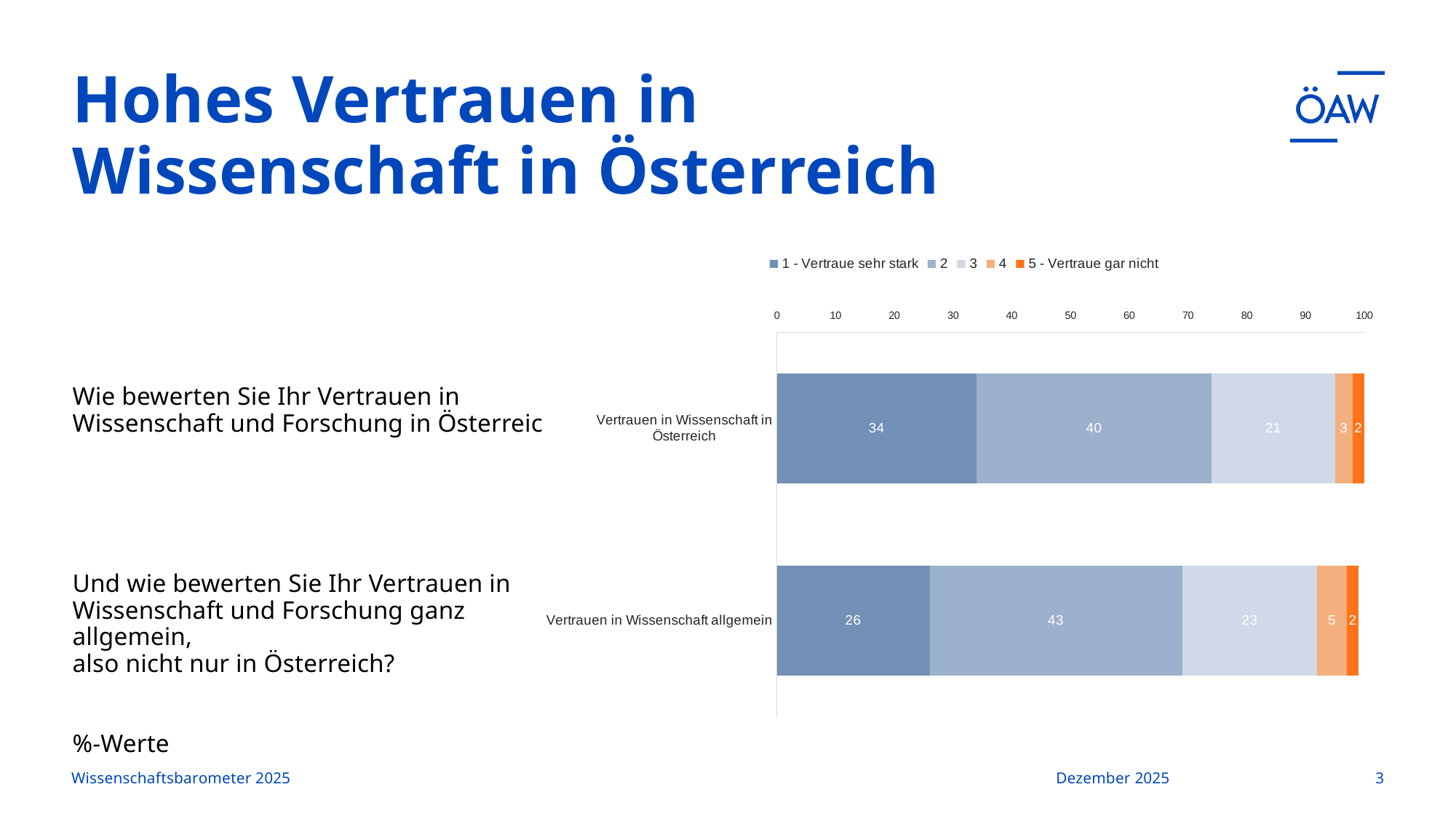
What is the value of series "2" for "Vertrauen in Wissenschaft allgemein"? 43 How many categories (bars) are plotted in the chart? 2 What is the total of the stacked bar for "Vertrauen in Wissenschaft in Österreich"? 100 Which is larger: the series "3" value for "Vertrauen in Wissenschaft in Österreich" or for "Vertrauen in Wissenschaft allgemein"? Vertrauen in Wissenschaft allgemein What kind of chart is shown on the slide? Stacked bar chart How many series does the legend list? 5 Which series has the highest value in the "Vertrauen in Wissenschaft allgemein" bar? 2 What is the difference between the "1 - Vertraue sehr stark" values for "Vertrauen in Wissenschaft in Österreich" and "Vertrauen in Wissenschaft allgemein"? 8 What is the value of "5 - Vertraue gar nicht" for "Vertrauen in Wissenschaft in Österreich"? 2 Which series has the lowest value in the "Vertrauen in Wissenschaft in Österreich" bar? 5 - Vertraue gar nicht What is the value of series "4" for "Vertrauen in Wissenschaft allgemein"? 5 What is the value of "1 - Vertraue sehr stark" for "Vertrauen in Wissenschaft in Österreich"? 34